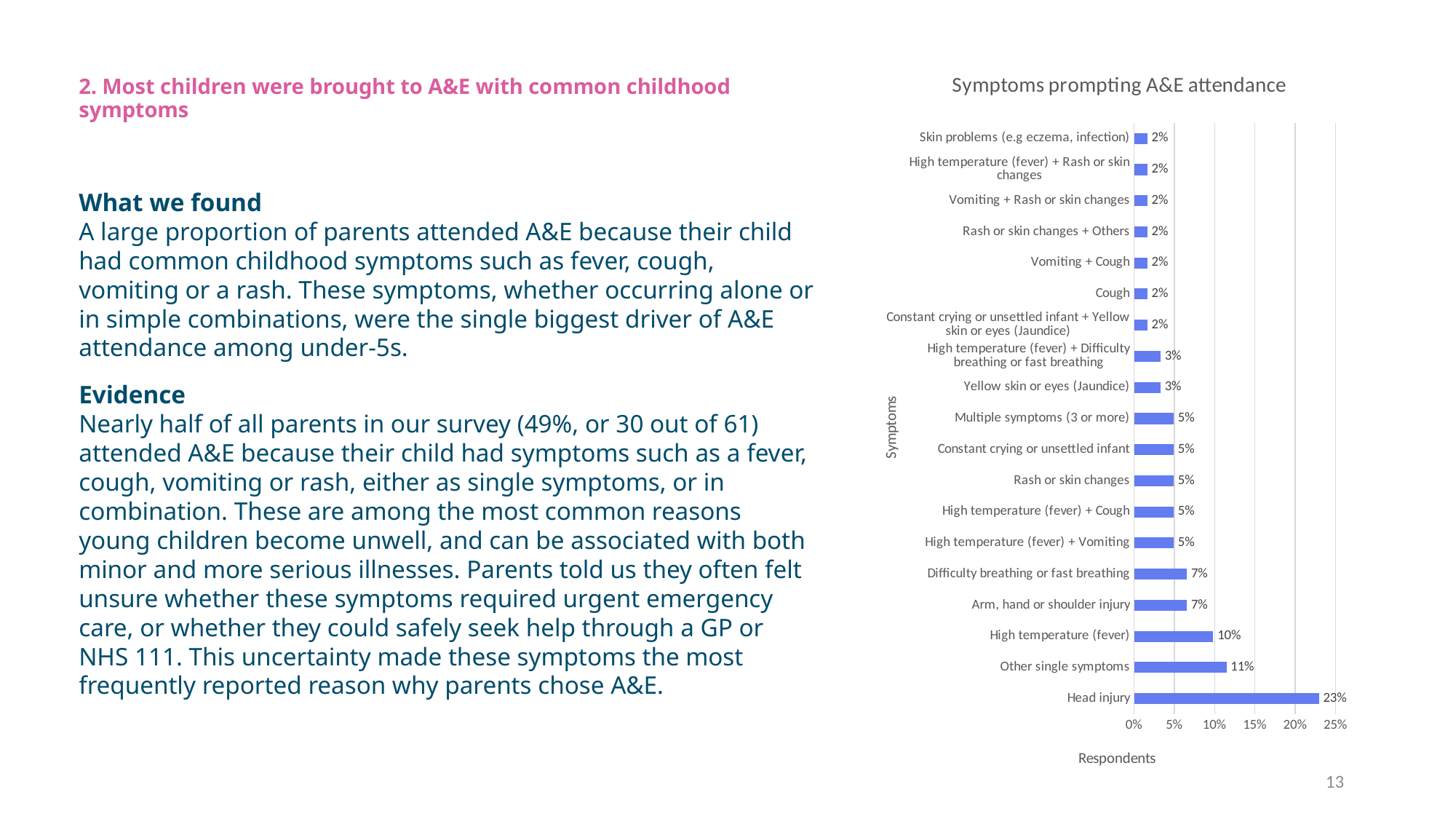
Which symptom has the highest value? Head injury What is the value for Difficulty breathing or fast breathing? 7% How many symptom categories are shown in the chart? 19 What is the title of the chart? Symptoms prompting A&E attendance What is the difference between Head injury and Other single symptoms? 12% What is the value for Other single symptoms? 11% What is the value for High temperature (fever)? 10% What is the value for Head injury? 23% What kind of chart is shown? Bar chart What is the label of the horizontal axis? Respondents Is the value for Head injury greater or less than 20%? greater Which is larger, High temperature (fever) or Arm, hand or shoulder injury? High temperature (fever)